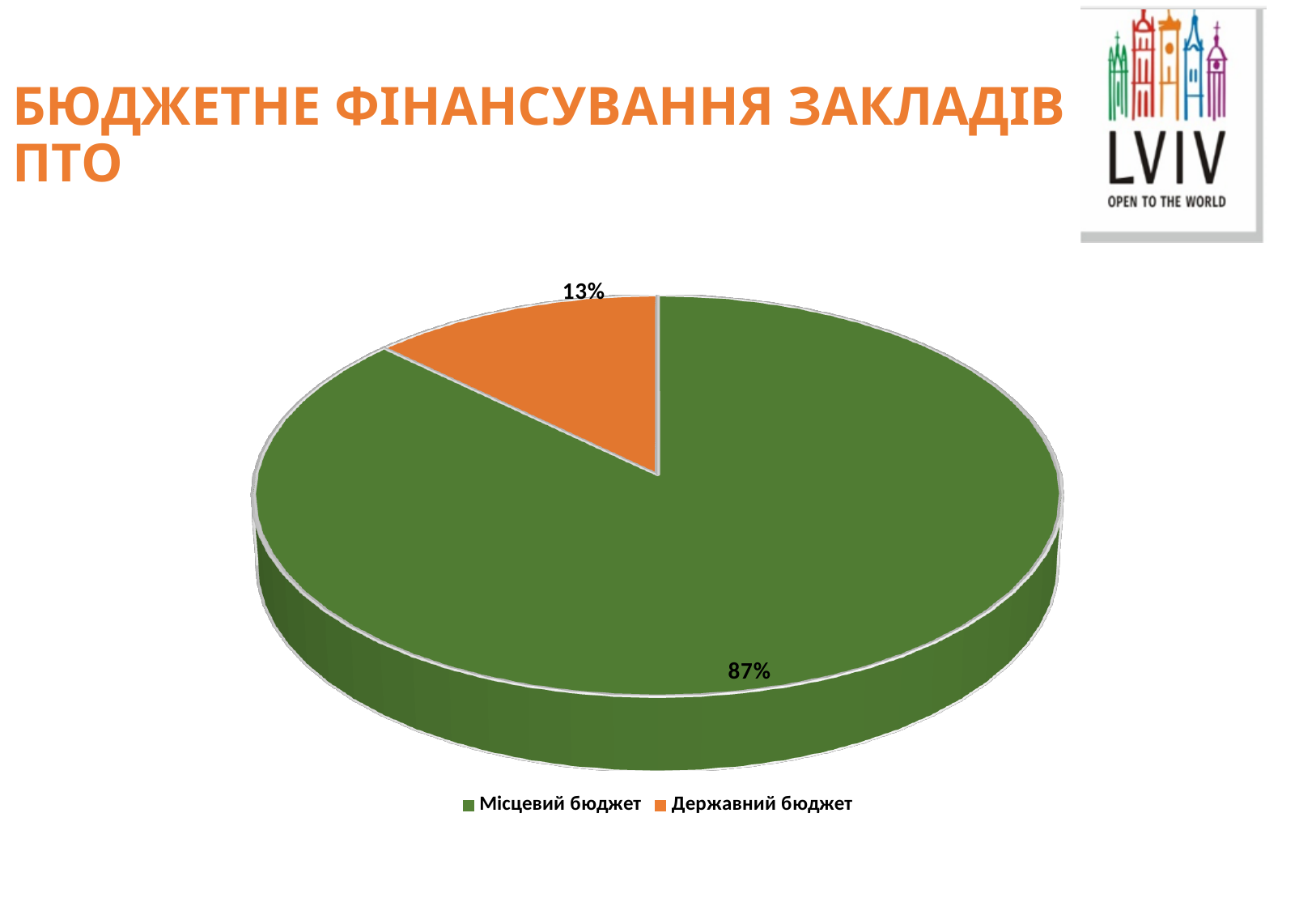
How many slices does the pie chart have? 2 What kind of chart is shown on the slide? Pie chart What share of the pie does Державний бюджет represent? 13% What is the difference in percentage points between Місцевий бюджет and Державний бюджет? 74 What share of the pie does Місцевий бюджет represent? 87% What is the title of the slide containing the chart? БЮДЖЕТНЕ ФІНАНСУВАННЯ ЗАКЛАДІВ ПТО Which category has the largest slice of the pie? Місцевий бюджет Which is larger, the share for Місцевий бюджет or the share for Державний бюджет? Місцевий бюджет How many entries does the legend list? 2 What colour is the slice for Державний бюджет? Orange Which category has the smallest slice of the pie? Державний бюджет